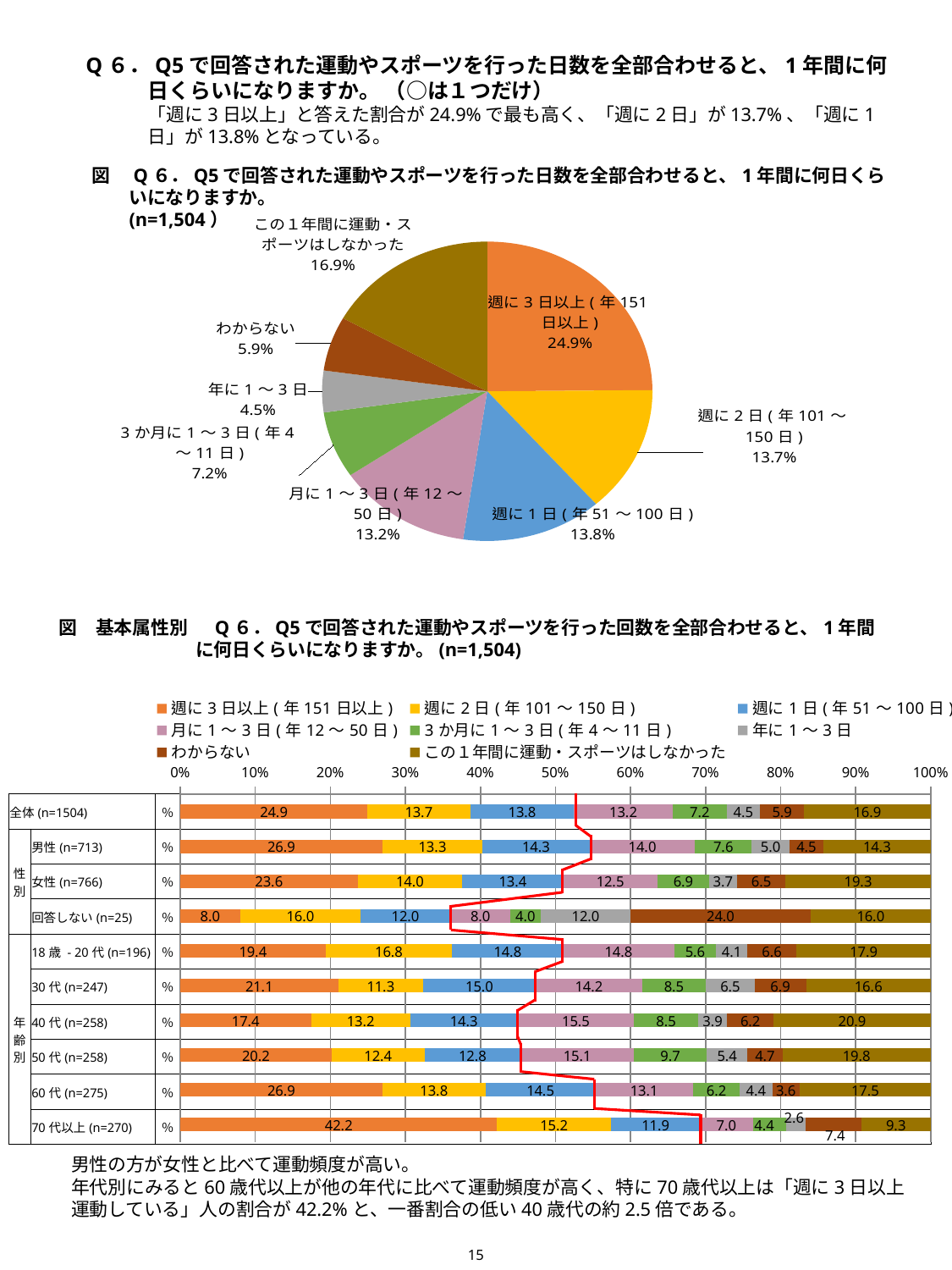
In the top pie chart, what percentage is shown for 「週に3日以上(年151日以上)」? 24.9% In the bottom bar chart, which is larger for 「週に3日以上(年151日以上)」: 男性 (n=713) or 女性 (n=766)? 男性 (n=713) In the bottom bar chart, what is the value of 「わからない」 for 回答しない (n=25)? 24.0 What kind of chart is the bottom chart (基本属性別)? bar chart In the top pie chart, what is the difference between 「週に3日以上(年151日以上)」 and 「この1年間に運動・スポーツはしなかった」? 8.0 percentage points In the bottom bar chart, what is the value of 「週に3日以上(年151日以上)」 for 70代以上 (n=270)? 42.2 In the top pie chart, which category has the smallest share? 年に1〜3日 How many respondent groups (rows) are plotted in the bottom bar chart? 10 How many slices does the top pie chart have? 8 How many series does the legend of the bottom chart list? 8 What kind of chart is the top chart (図 Q6, n=1,504)? pie chart In the top pie chart, which category has the largest share? 週に3日以上(年151日以上)